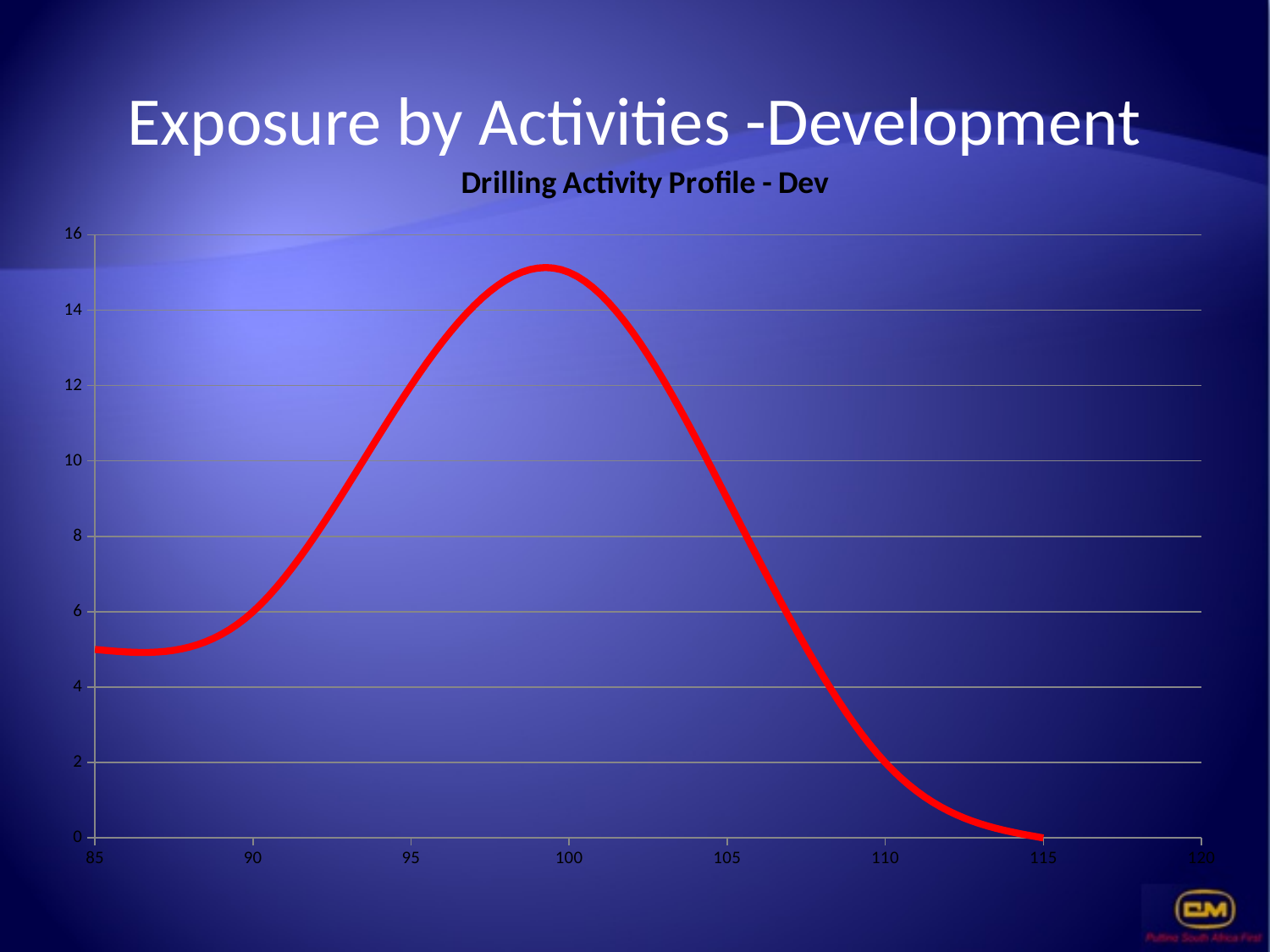
Among the x-axis ticks 95, 100 and 105, at which is the value highest? 100 Does the line rise or fall between x = 100 and x = 115? fall What kind of chart is shown on the slide? line chart Is the value at x = 100 greater or less than 14? greater Is the value at x = 95 greater or less than 10? greater Which is larger, the value at x = 95 or the value at x = 105? x = 95 Is the value at x = 85 greater or less than 6? less Does the line rise or fall between x = 90 and x = 100? rise What is the title of the chart? Drilling Activity Profile - Dev What colour is the plotted line? red